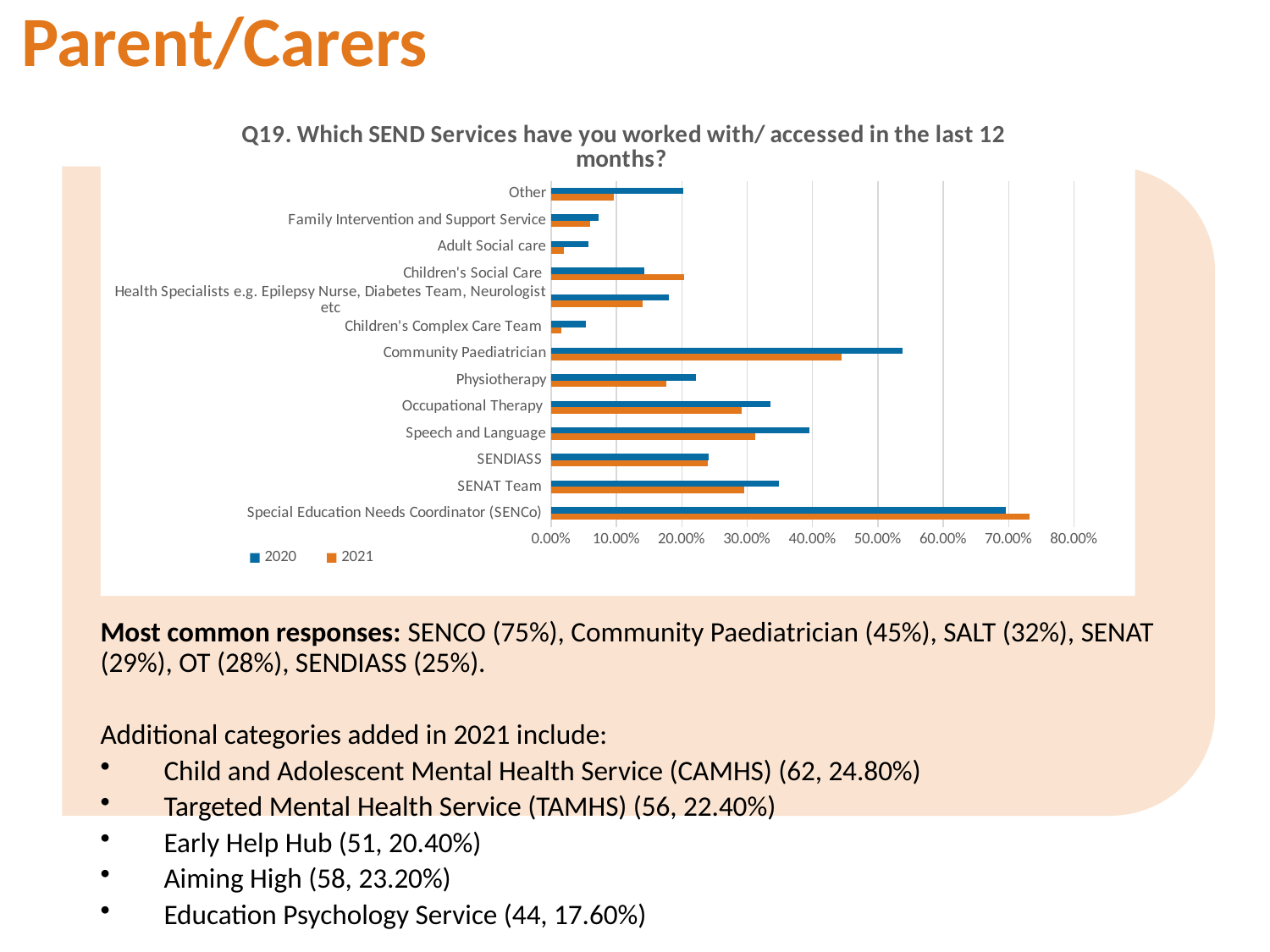
Which colour represents the 2021 series in the chart? Orange For Community Paediatrician, which year has the larger value, 2020 or 2021? 2020 Is the 2020 value for Special Education Needs Coordinator (SENCo) greater or less than 60.00%? greater How many series does the chart legend list? 2 What kind of chart is shown on the slide? Bar chart Is the 2021 value for Community Paediatrician greater or less than 50.00%? less Which category has the highest value for 2020? Special Education Needs Coordinator (SENCo) For Children's Social Care, which year has the larger value, 2020 or 2021? 2021 Is the 2020 value for SENAT Team greater or less than 30.00%? greater How many service categories are plotted on the chart? 13 Which category has the highest value for 2021? Special Education Needs Coordinator (SENCo)